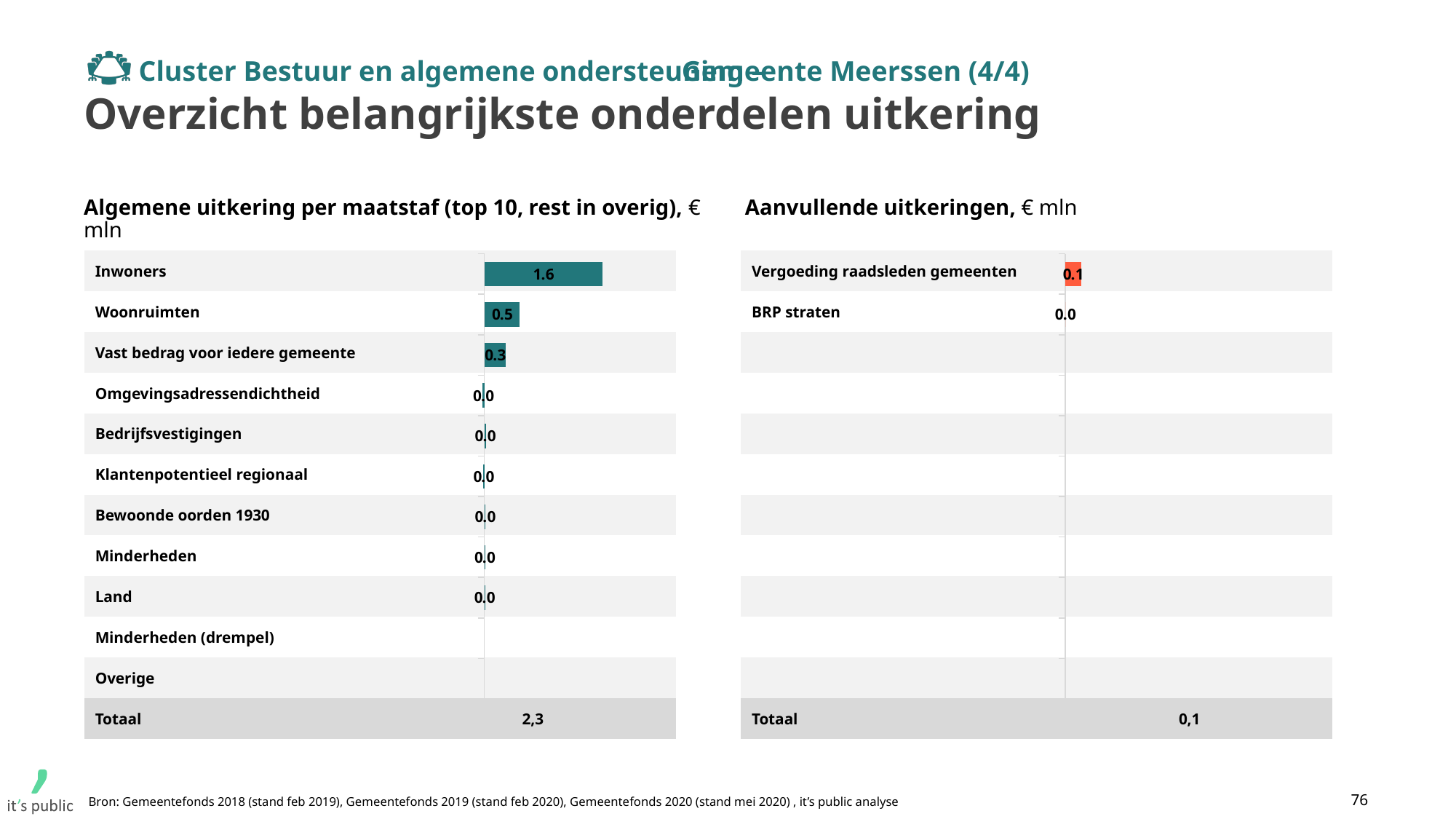
What kind of chart is used for 'Algemene uitkering per maatstaf'? Bar chart In the chart 'Algemene uitkering per maatstaf', which is larger: Woonruimten or Vast bedrag voor iedere gemeente? Woonruimten In the chart 'Algemene uitkering per maatstaf', what is the difference between the values for Inwoners and Woonruimten? 1.1 In the chart 'Aanvullende uitkeringen', what is the value for Vergoeding raadsleden gemeenten? 0.1 In the chart 'Aanvullende uitkeringen', what is the value for BRP straten? 0.0 In the chart 'Algemene uitkering per maatstaf', what is the value for Woonruimten? 0.5 In the chart 'Algemene uitkering per maatstaf', how many categories show a value of 0.0? 6 In the chart 'Algemene uitkering per maatstaf', what is the value for Inwoners? 1.6 In the chart 'Algemene uitkering per maatstaf', which category has the highest value? Inwoners In the chart 'Algemene uitkering per maatstaf', what is the Totaal value shown? 2,3 In the chart 'Algemene uitkering per maatstaf', what is the value for Vast bedrag voor iedere gemeente? 0.3 In the chart 'Aanvullende uitkeringen', what is the Totaal value shown? 0,1